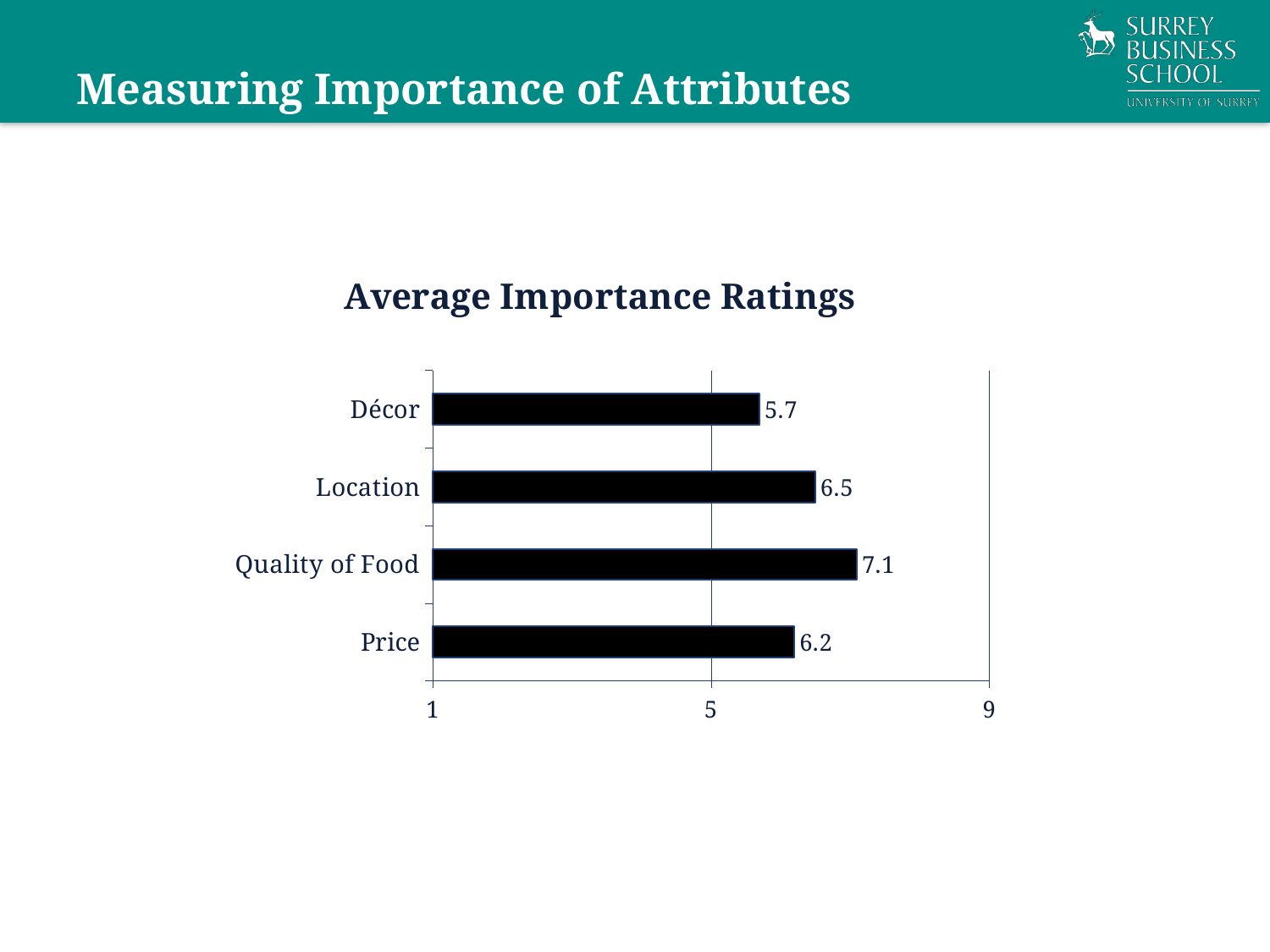
What is the average importance rating for Décor? 5.7 What is the difference between the ratings for Location and Price? 0.3 Is the value for Décor greater or less than 5? greater Which attribute has the lowest average importance rating? Décor What is the difference between the ratings for Quality of Food and Décor? 1.4 What is the average importance rating for Quality of Food? 7.1 What kind of chart is shown on the slide? Bar chart What is the average importance rating for Price? 6.2 How many attributes are shown in the chart? 4 Which has a higher average importance rating, Location or Price? Location What is the average importance rating for Location? 6.5 Which attribute has the highest average importance rating? Quality of Food